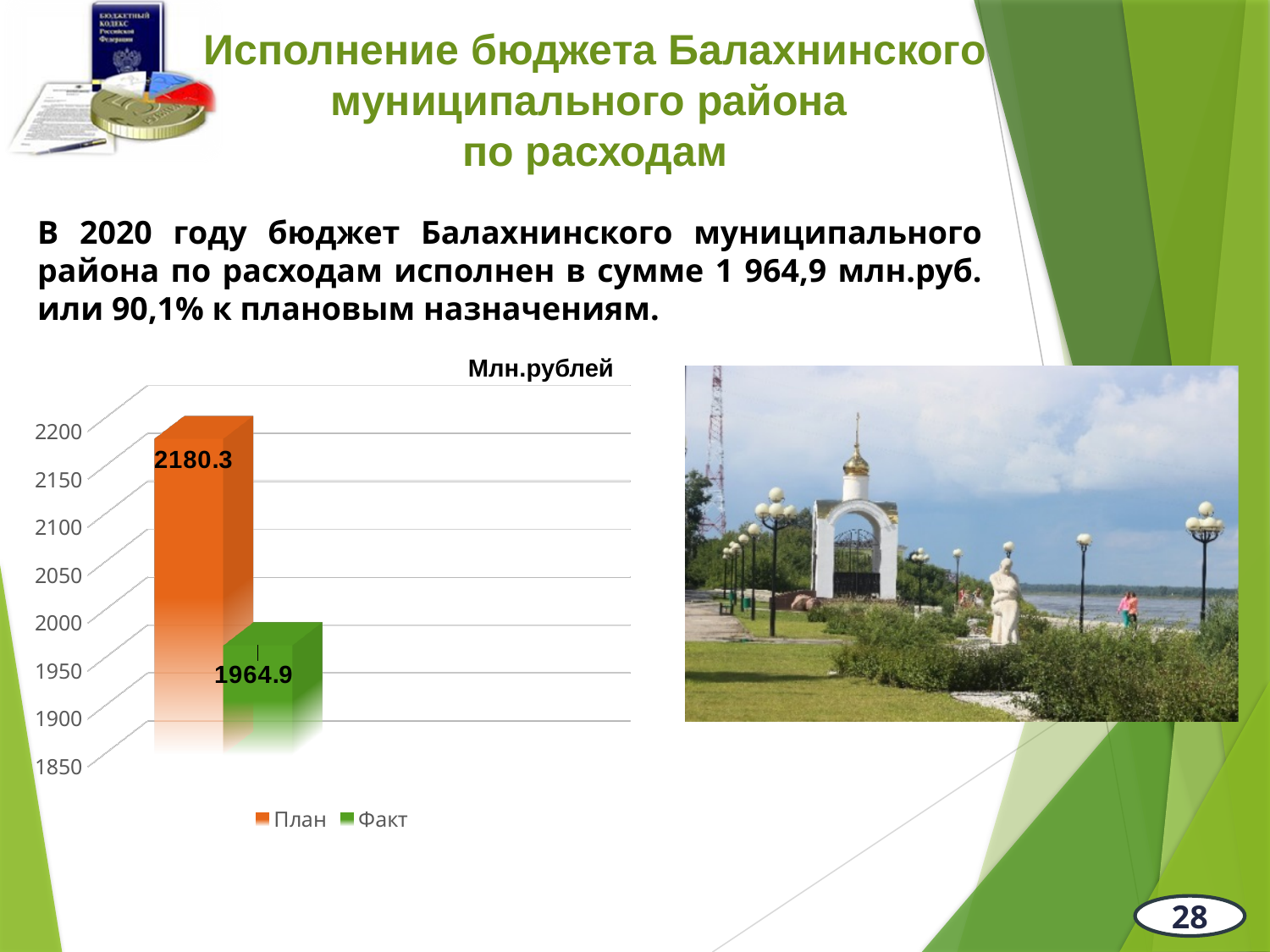
What is the value for План (plan) in the chart? 2180.3 Is the value for Факт greater or less than 2000? less Which bar is the lowest in the chart? Факт Which series has the higher value, План or Факт? План What colour is the Факт bar in the chart? green Which bar is the highest in the chart? План What unit label is shown above the chart? Млн.рублей Is the value for План greater or less than 2150? greater What is the difference between the План value and the Факт value? 215.4 How many series does the legend list? 2 What is the value for Факт (actual) in the chart? 1964.9 What kind of chart is shown on the slide? bar chart